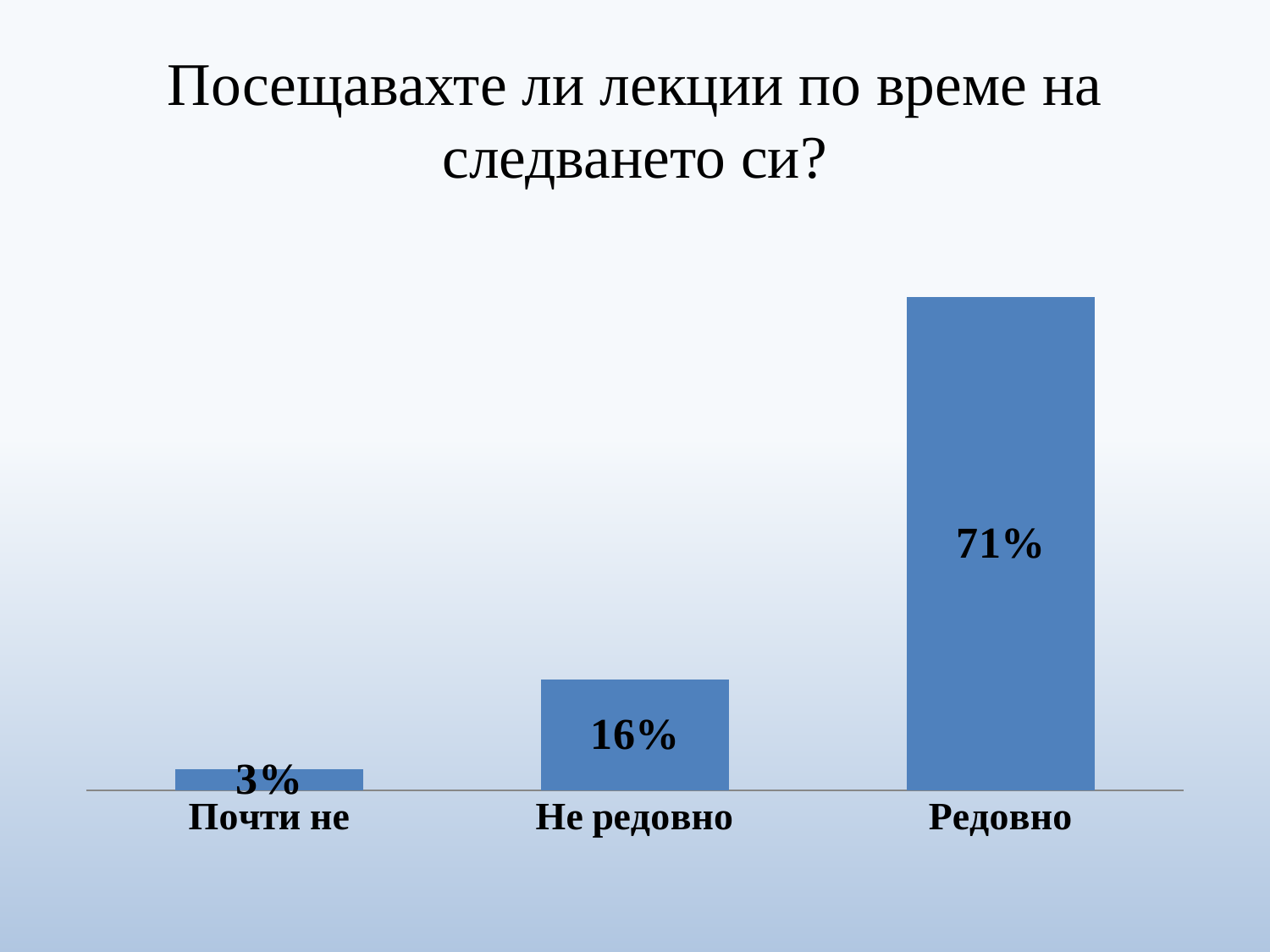
What is the value for "Почти не"? 3% Which category has the highest value? Редовно Which category has the lowest value? Почти не How many categories are shown on the chart? 3 What is the title of the slide? Посещавахте ли лекции по време на следването си? What kind of chart is shown on the slide? Bar chart What is the difference between the values for "Не редовно" and "Почти не"? 13% What is the difference between the values for "Редовно" and "Не редовно"? 55% Do the values rise or fall from left to right along the x axis? Rise What is the value for "Не редовно"? 16% Which is larger, the value for "Не редовно" or the value for "Почти не"? Не редовно What is the value for "Редовно"? 71%